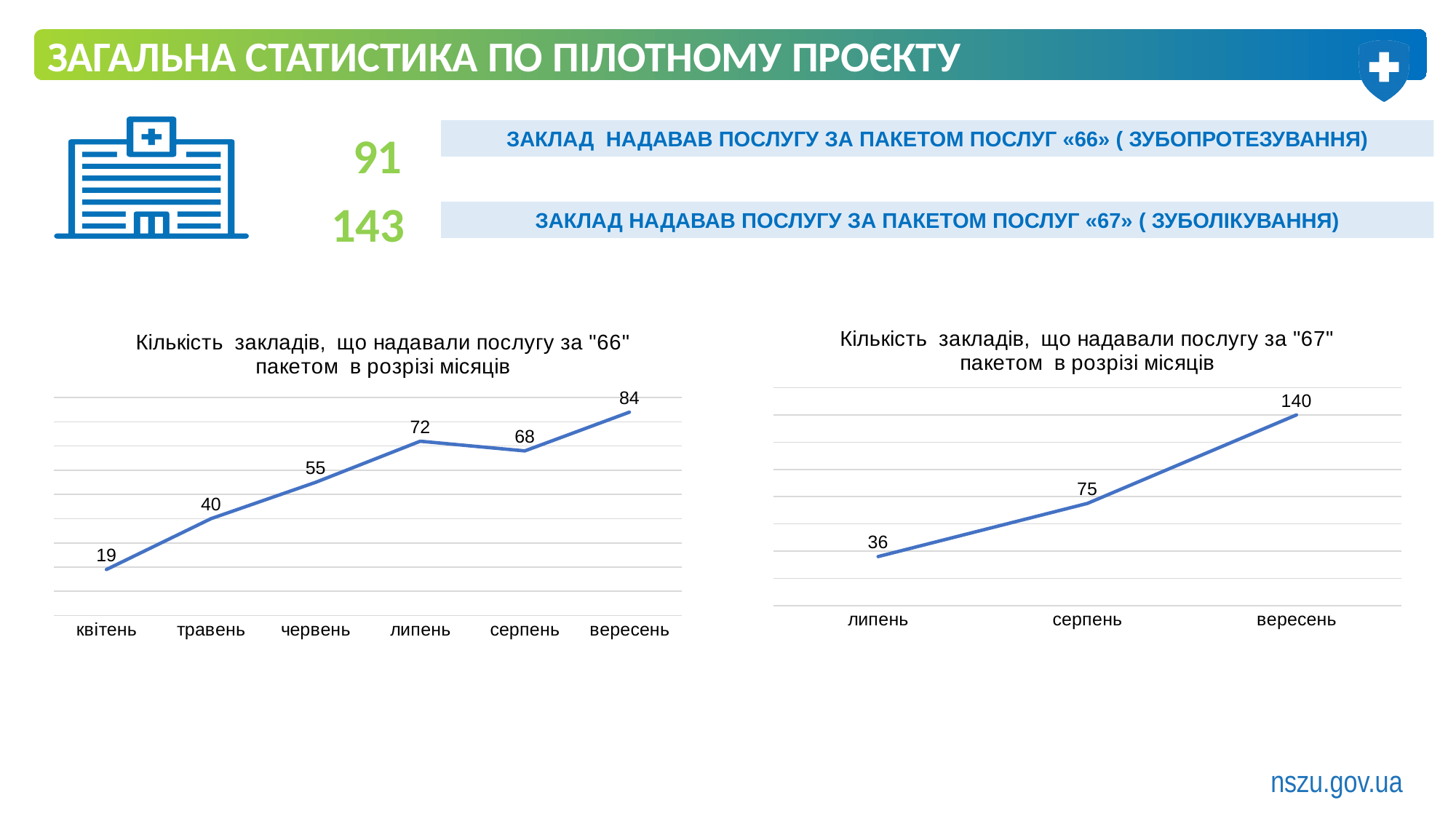
In the left chart (package "66"), which month has the highest value? вересень In the left chart (package "66"), what is the value for квітень? 19 How many months are plotted in the left chart (package "66")? 6 In the right chart (package "67"), what is the value for серпень? 75 How many months are plotted in the right chart (package "67")? 3 In the left chart (package "66"), what is the difference between the values for вересень and серпень? 16 What type of chart is the right chart (package "67")? line chart In the right chart (package "67"), which month has the lowest value? липень In the right chart (package "67"), do the values rise or fall from липень to вересень? rise In the left chart (package "66"), what is the value for липень? 72 In the right chart (package "67"), what is the difference between the values for вересень and липень? 104 In the left chart (package "66"), which is larger, the value for липень or the value for серпень? липень